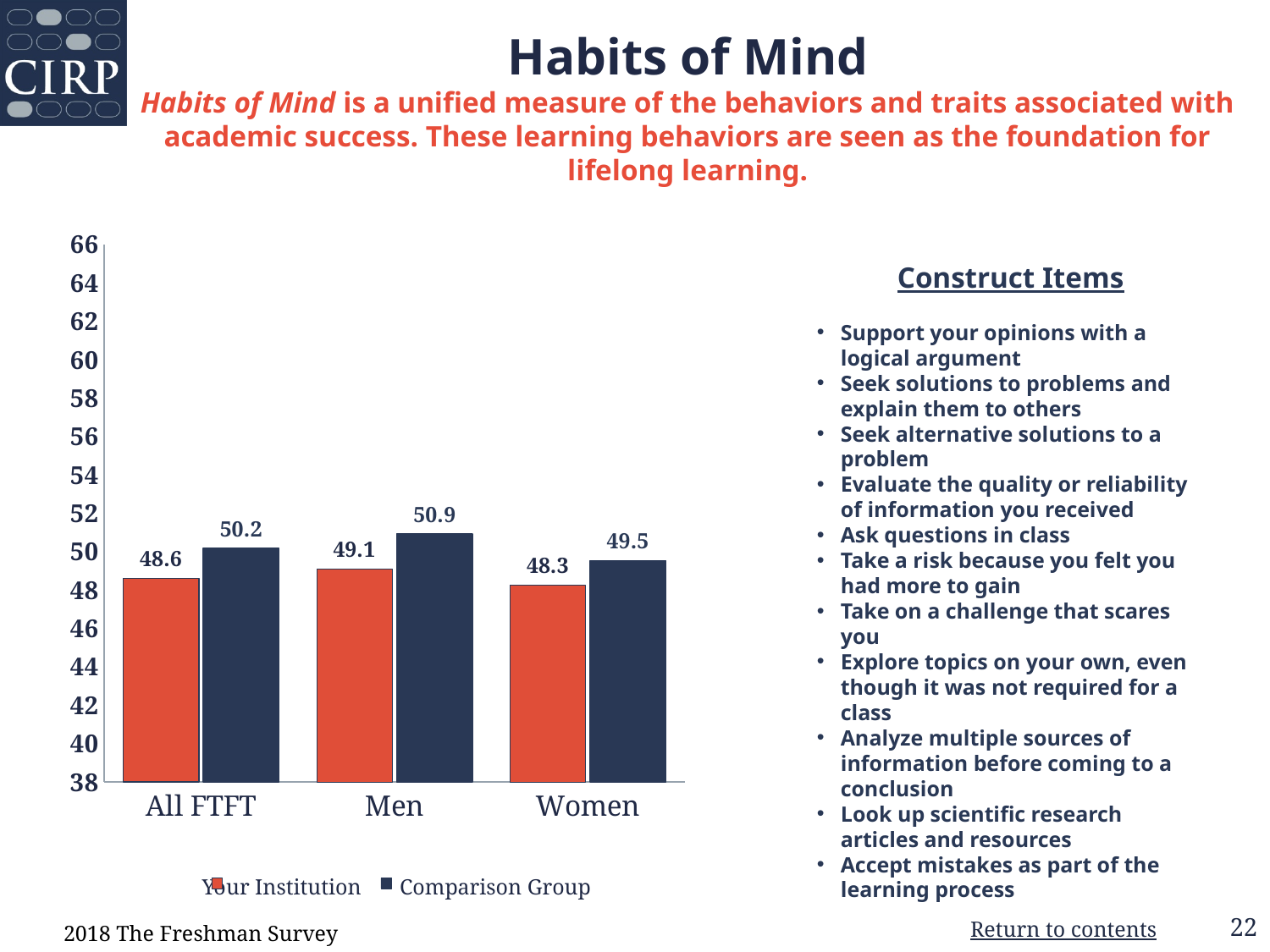
What is the Your Institution value for All FTFT? 48.6 How many series does the legend list? 2 What is the Comparison Group value for Women? 49.5 What kind of chart is shown on the slide? Bar chart Which category has the lowest Your Institution value? Women What is the difference between the Comparison Group and Your Institution values for All FTFT? 1.6 What colour are the Comparison Group bars? Dark navy blue What is the Your Institution value for Men? 49.1 For Women, which is larger: Your Institution or Comparison Group? Comparison Group What is the difference between the Comparison Group and Your Institution values for Men? 1.8 Which category has the highest Comparison Group value? Men How many categories are shown on the x axis? 3